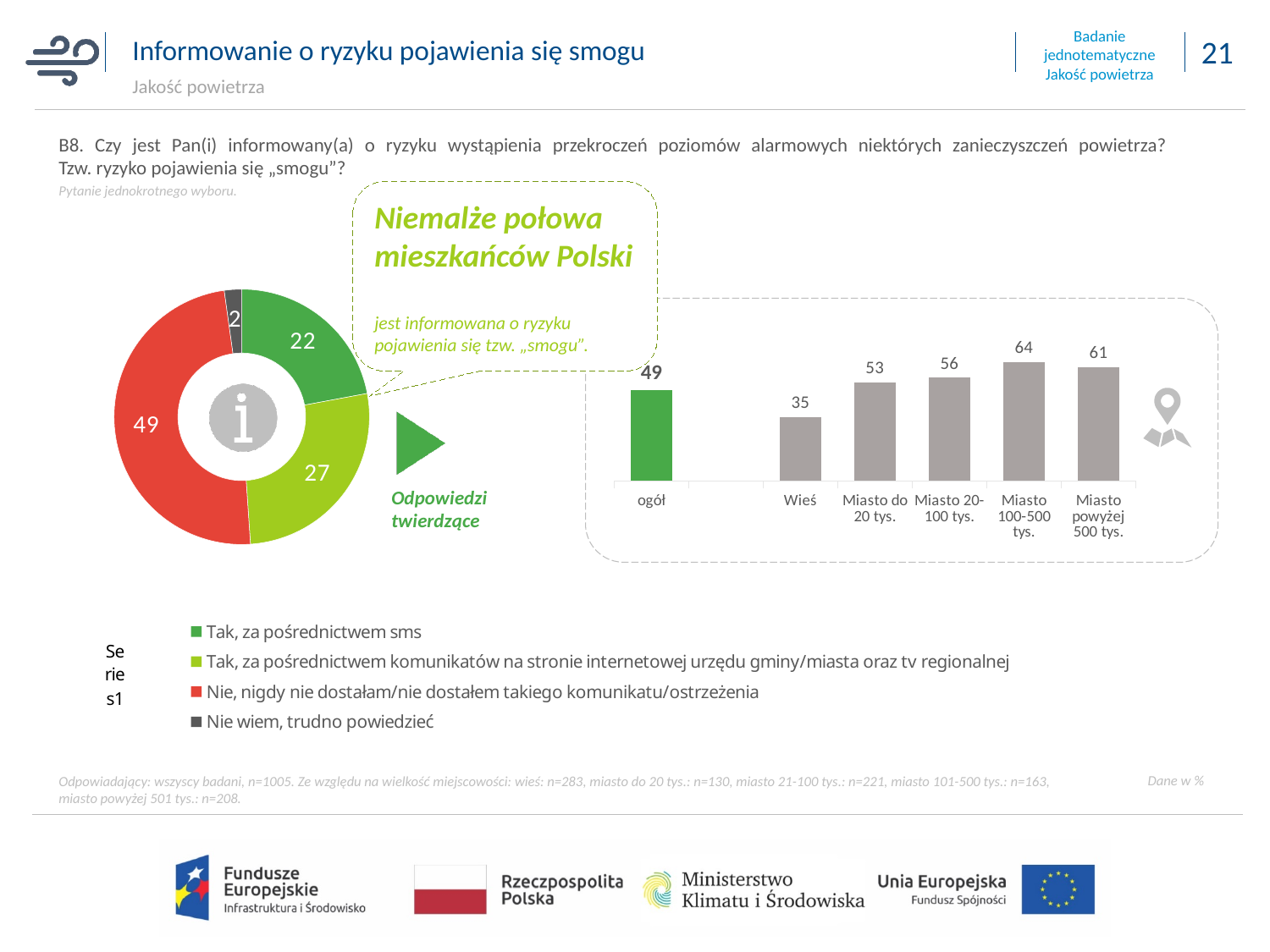
In the bar chart on the right, which is larger: the value for Miasto do 20 tys. or the value for Miasto 20-100 tys.? Miasto 20-100 tys. How many categories are shown in the bar chart on the right? 6 In the donut chart on the left, what is the value for 'Tak, za pośrednictwem sms'? 22 In the bar chart on the right, what is the value for ogół? 49 In the donut chart on the left, what is the value for 'Nie, nigdy nie dostałam/nie dostałem takiego komunikatu/ostrzeżenia'? 49 In the donut chart on the left, which category has the smallest slice? Nie wiem, trudno powiedzieć In the bar chart on the right, what is the difference between the values for Miasto powyżej 500 tys. and Wieś? 26 In the bar chart on the right, which category has the lowest value? Wieś In the bar chart on the right, which category has the highest value? Miasto 100-500 tys. How many entries does the legend of the donut chart list? 4 In the bar chart on the right, what is the value for Wieś? 35 In the bar chart on the right, what is the value for Miasto 100-500 tys.? 64